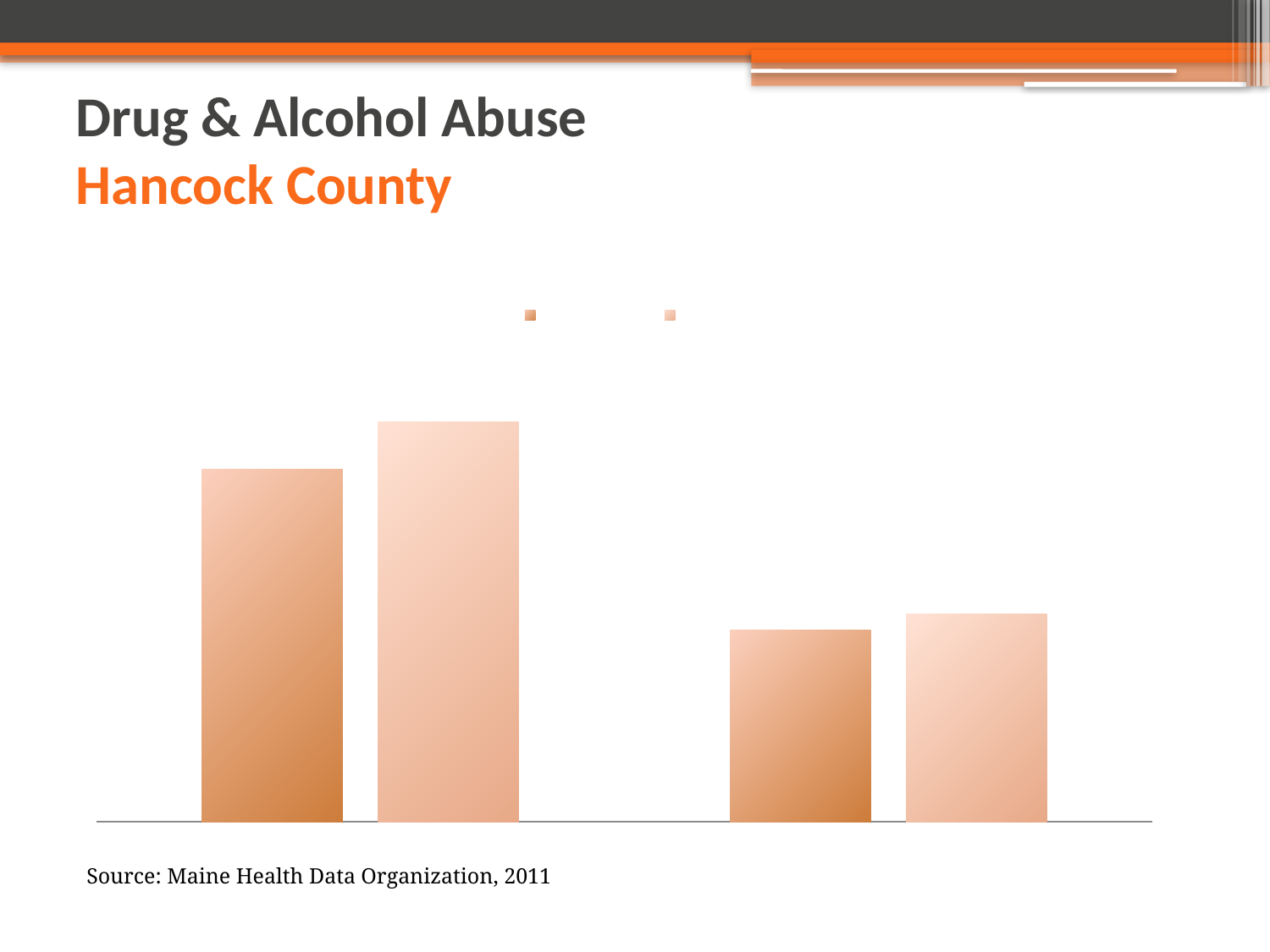
How many series does the chart's legend show? 2 Which bar is the shortest in the chart: the first, second, third or fourth from the left? third What is the source cited below the chart? Maine Health Data Organization, 2011 Within the left group of bars, is the lighter bar taller or shorter than the darker bar? taller How many groups of bars are there in the chart? 2 How many bars are plotted in the chart? 4 In the chart, is the left group of bars taller or shorter than the right group of bars? taller Within the right group of bars, is the lighter bar taller or shorter than the darker bar? taller Which bar is the tallest in the chart: the first, second, third or fourth from the left? second What kind of chart is shown on the slide? bar chart Which county does the slide title say the chart is about? Hancock County